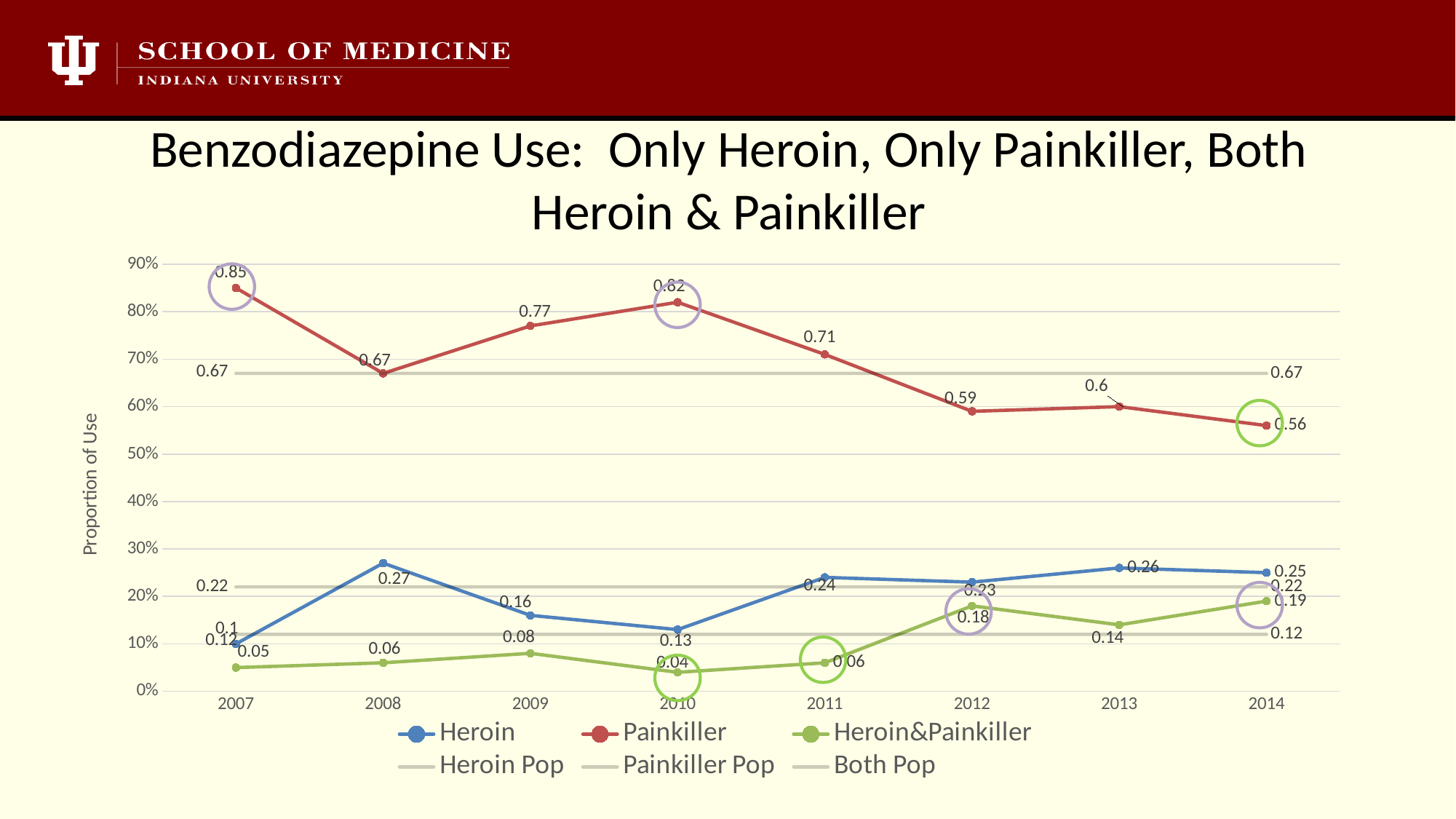
What is the Heroin value in 2008? 0.27 How many years are shown on the x axis? 8 Which is larger in 2011, the Heroin value or the Heroin&Painkiller value? Heroin In which year is the Heroin&Painkiller series lowest? 2010 In which year is the Painkiller series highest? 2007 What is the Heroin&Painkiller value in 2012? 0.18 Is the Heroin value in 2013 greater or less than 20%? greater Does the Painkiller series rise or fall from 2010 to 2014? fall What is the difference between the Painkiller values in 2007 and 2014? 0.29 What is the Painkiller value in 2007? 0.85 How many series does the legend list? 6 What kind of chart is shown on the slide? line chart